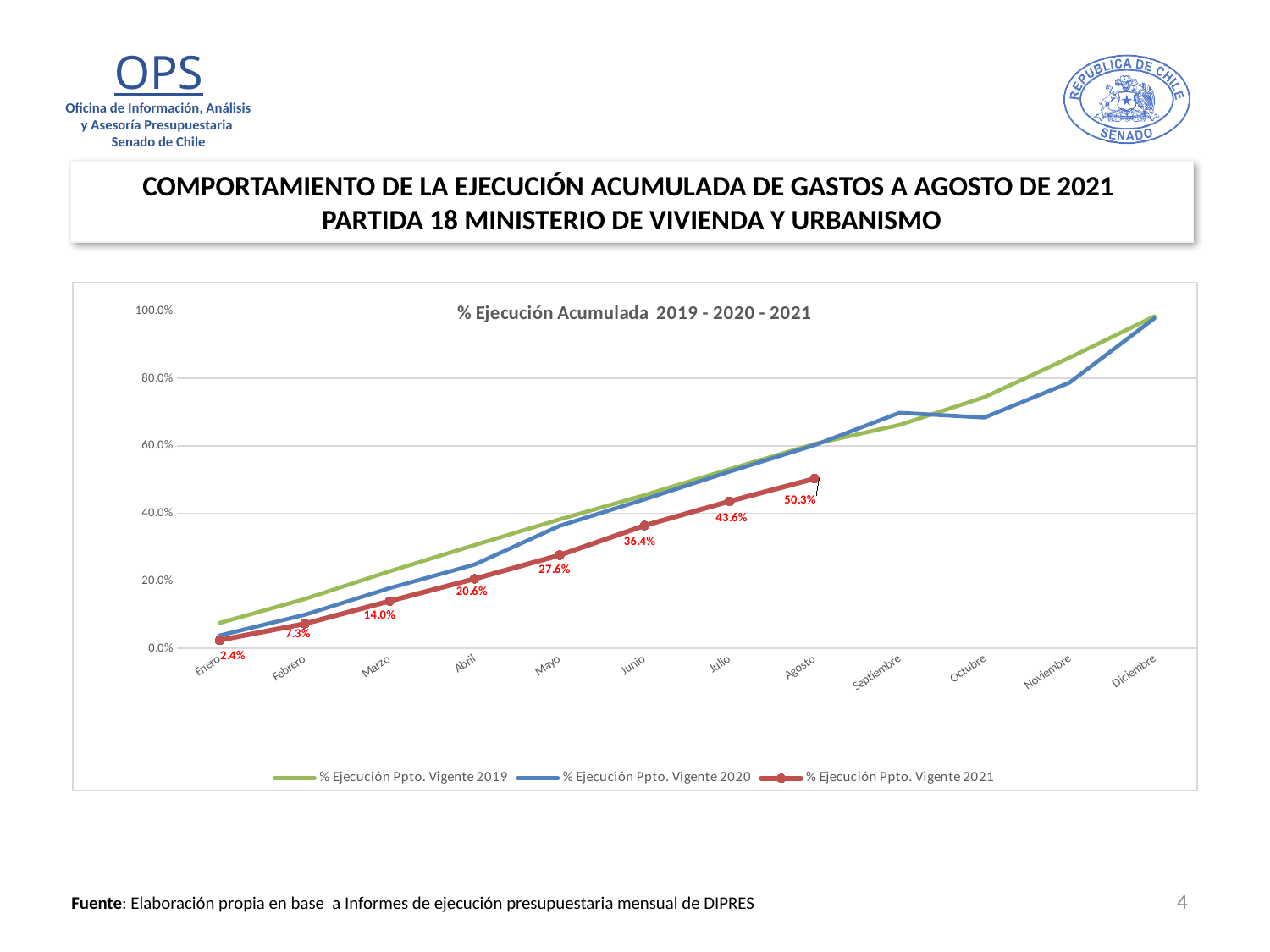
What kind of chart is shown on the slide? Line chart Is the value for % Ejecución Ppto. Vigente 2020 in Octubre greater or less than 60.0%? greater Which month has the highest labeled value for % Ejecución Ppto. Vigente 2021? Agosto What is the difference between the 2021 values for Agosto and Julio? 6.7% What is the title of the chart? % Ejecución Acumulada 2019 - 2020 - 2021 What is the value of % Ejecución Ppto. Vigente 2021 for Agosto? 50.3% What is the value of % Ejecución Ppto. Vigente 2021 for Enero? 2.4% What is the difference between the 2021 values for Junio and Mayo? 8.8% Do the values of % Ejecución Ppto. Vigente 2021 rise or fall from Enero to Agosto? Rise How many months are shown on the x axis? 12 How many series does the legend list? 3 What is the value of % Ejecución Ppto. Vigente 2021 for Marzo? 14.0%